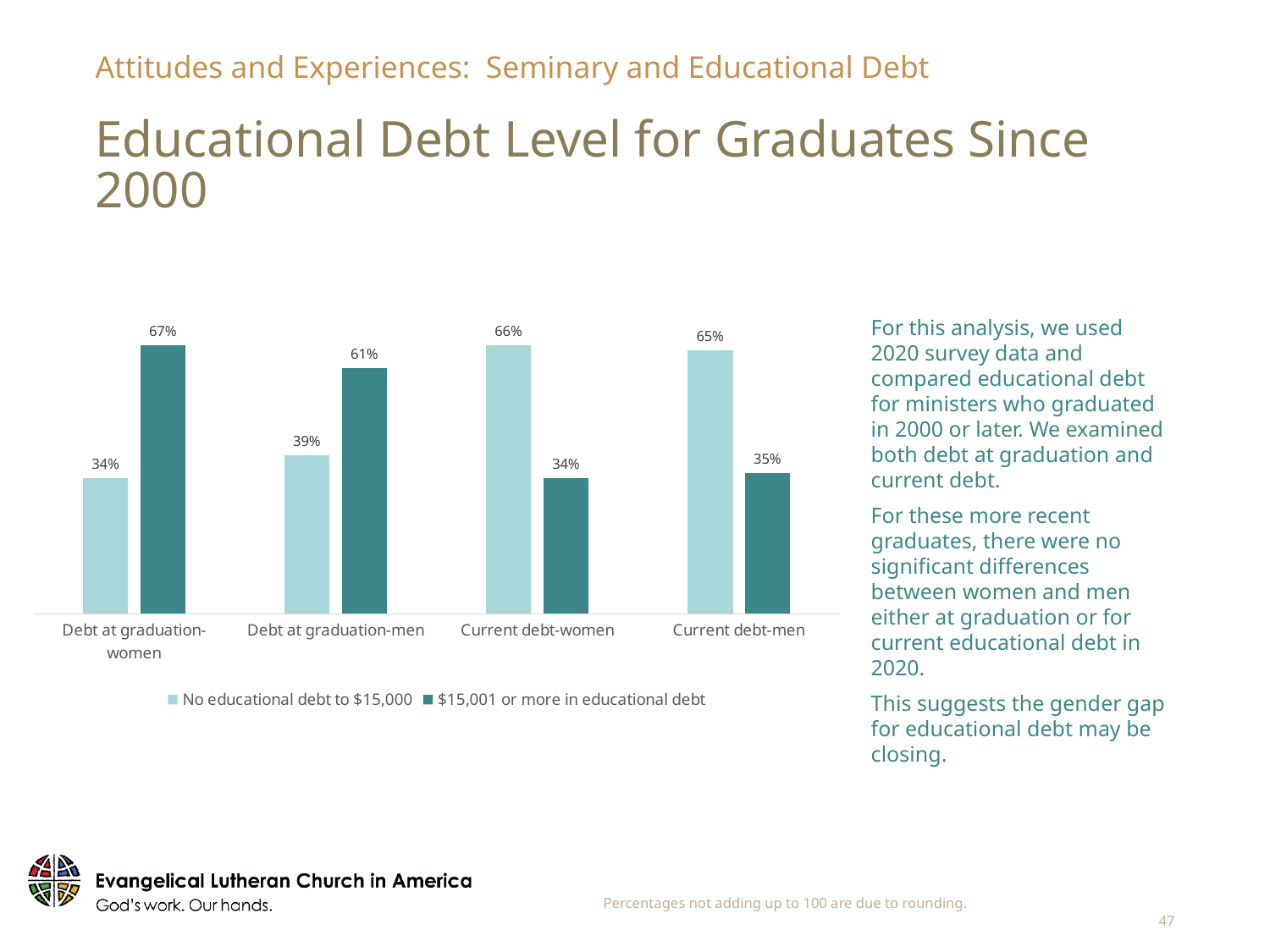
What is the value for $15,001 or more in educational debt for Current debt-women? 34% How many categories are shown on the x axis? 4 Which series is shown in the darker teal colour? $15,001 or more in educational debt What kind of chart is shown on the slide? Bar chart What percentage of men had $15,001 or more in educational debt at graduation? 61% Which is larger: the No educational debt to $15,000 value for Current debt-women or for Debt at graduation-men? Current debt-women What is the value for No educational debt to $15,000 for Current debt-men? 65% Which category has the lowest value for No educational debt to $15,000? Debt at graduation-women How many series does the legend list? 2 What percentage of women had no educational debt to $15,000 at graduation? 34% What is the difference between the $15,001 or more values for Debt at graduation-women and Debt at graduation-men? 6% Which category has the highest value for $15,001 or more in educational debt? Debt at graduation-women